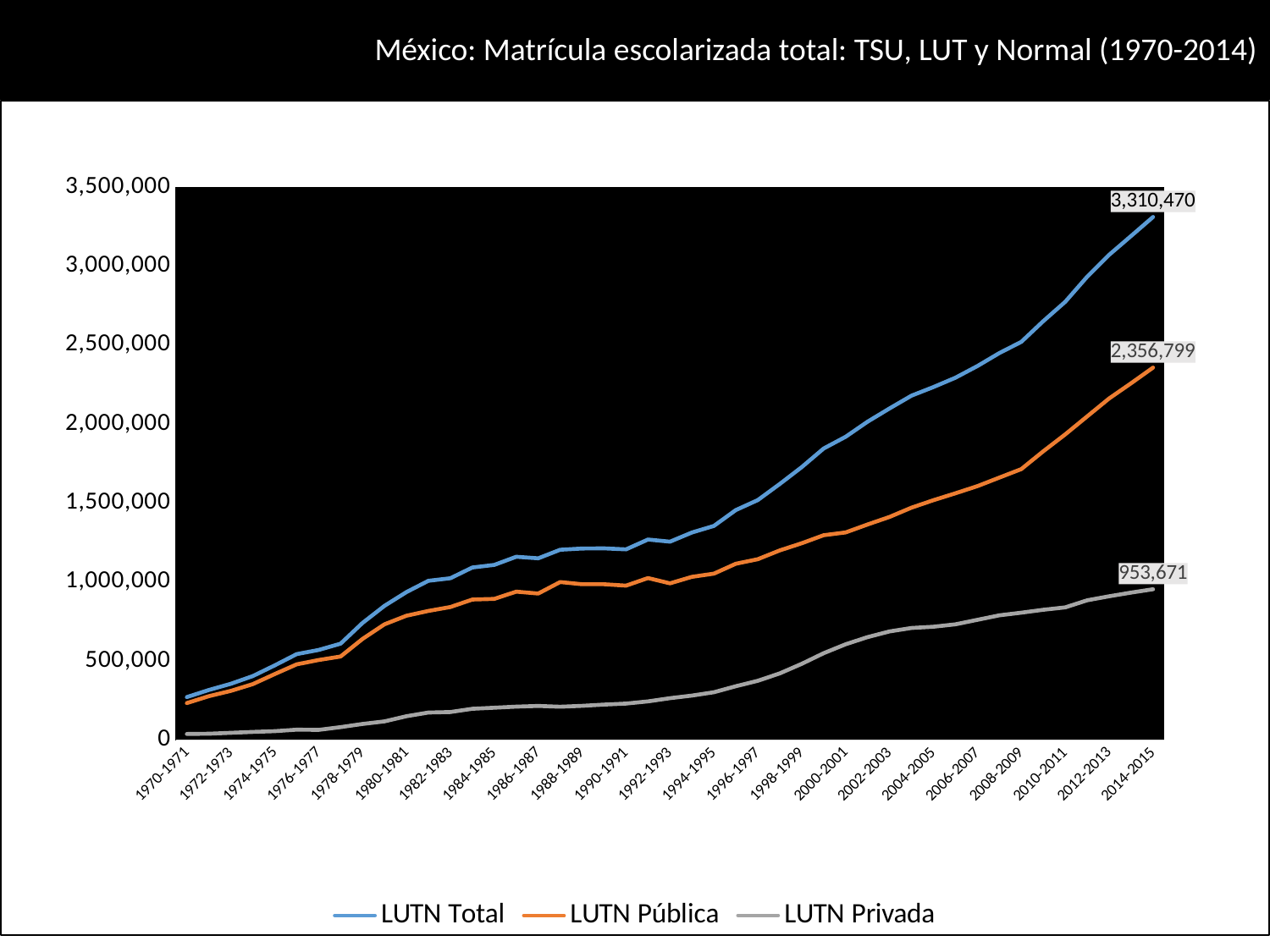
What is the difference between LUTN Pública and LUTN Privada in 2014-2015? 1,403,128 Is the value for LUTN Total in 2000-2001 greater or less than 1,500,000? greater Which series has the highest value in 2014-2015? LUTN Total What is the value of LUTN Total in 2014-2015? 3,310,470 What kind of chart is shown on the slide? line chart Which is larger in 2014-2015, LUTN Pública or LUTN Privada? LUTN Pública How many series does the legend list? 3 What is the difference between LUTN Total and LUTN Pública in 2014-2015? 953,671 Is the value for LUTN Privada in 2000-2001 greater or less than 1,000,000? less What is the value of LUTN Privada in 2014-2015? 953,671 Do the values for LUTN Total rise or fall from 1970-1971 to 2014-2015? rise What is the value of LUTN Pública in 2014-2015? 2,356,799